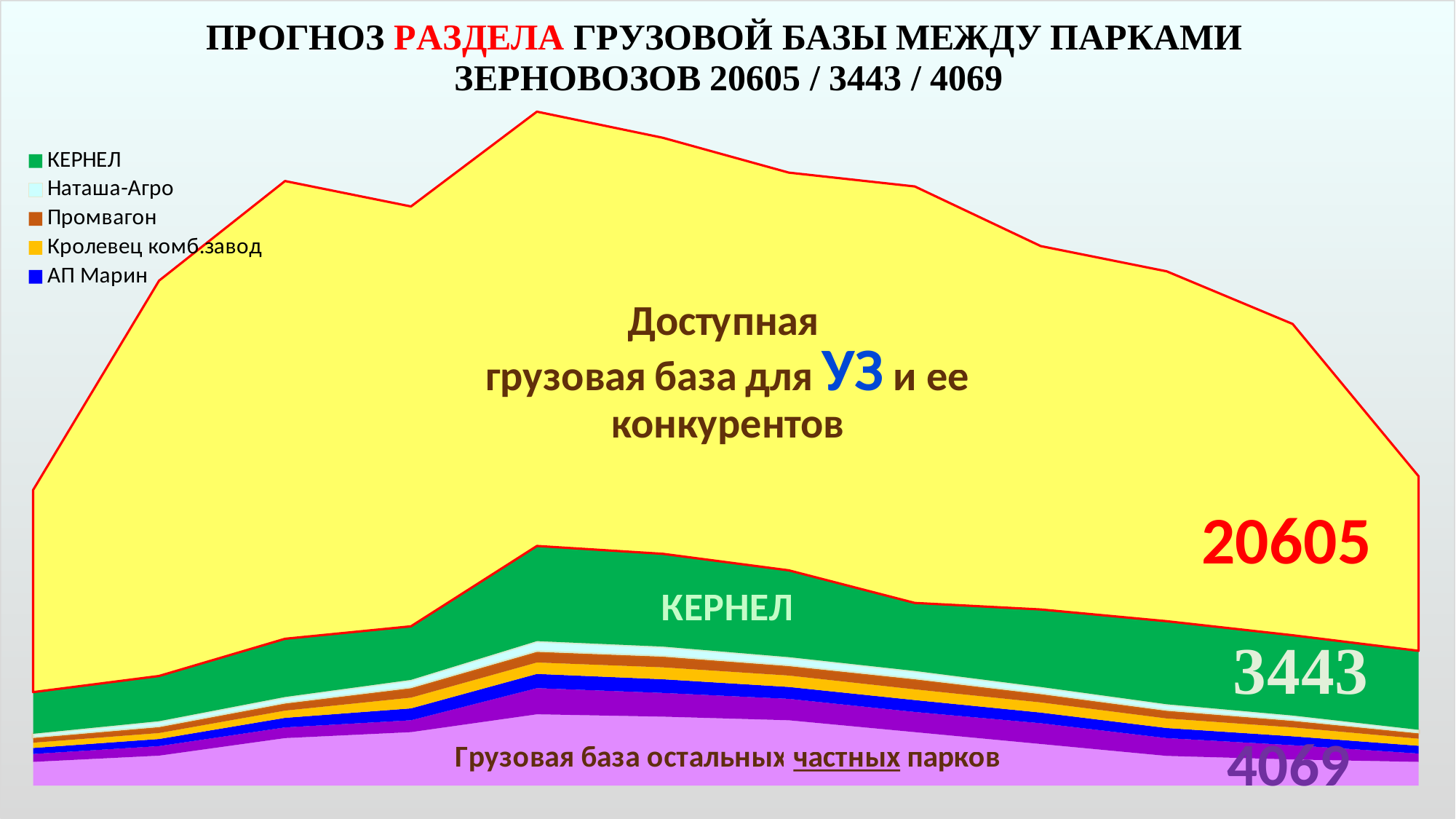
What value is printed on the green КЕРНЕЛ area? 3443 Which is larger: the value for КЕРНЕЛ or the value for the other private fleets? the other private fleets (4069) Which legend entry is listed first? КЕРНЕЛ What is the difference between the other private fleets value 4069 and the КЕРНЕЛ value 3443? 626 What value is printed on the purple area for the cargo base of other private fleets? 4069 What kind of chart is shown on the slide? area chart Which of the three labelled areas has the largest printed value? the yellow area (20605) What is the difference between the value 20605 and the КЕРНЕЛ value 3443? 17162 Which of the three labelled areas has the smallest printed value? КЕРНЕЛ (3443) How many series does the legend list? 5 What colour represents АП Марин in the legend? blue What value is printed on the yellow area labelled as the available cargo base for УЗ and its competitors? 20605